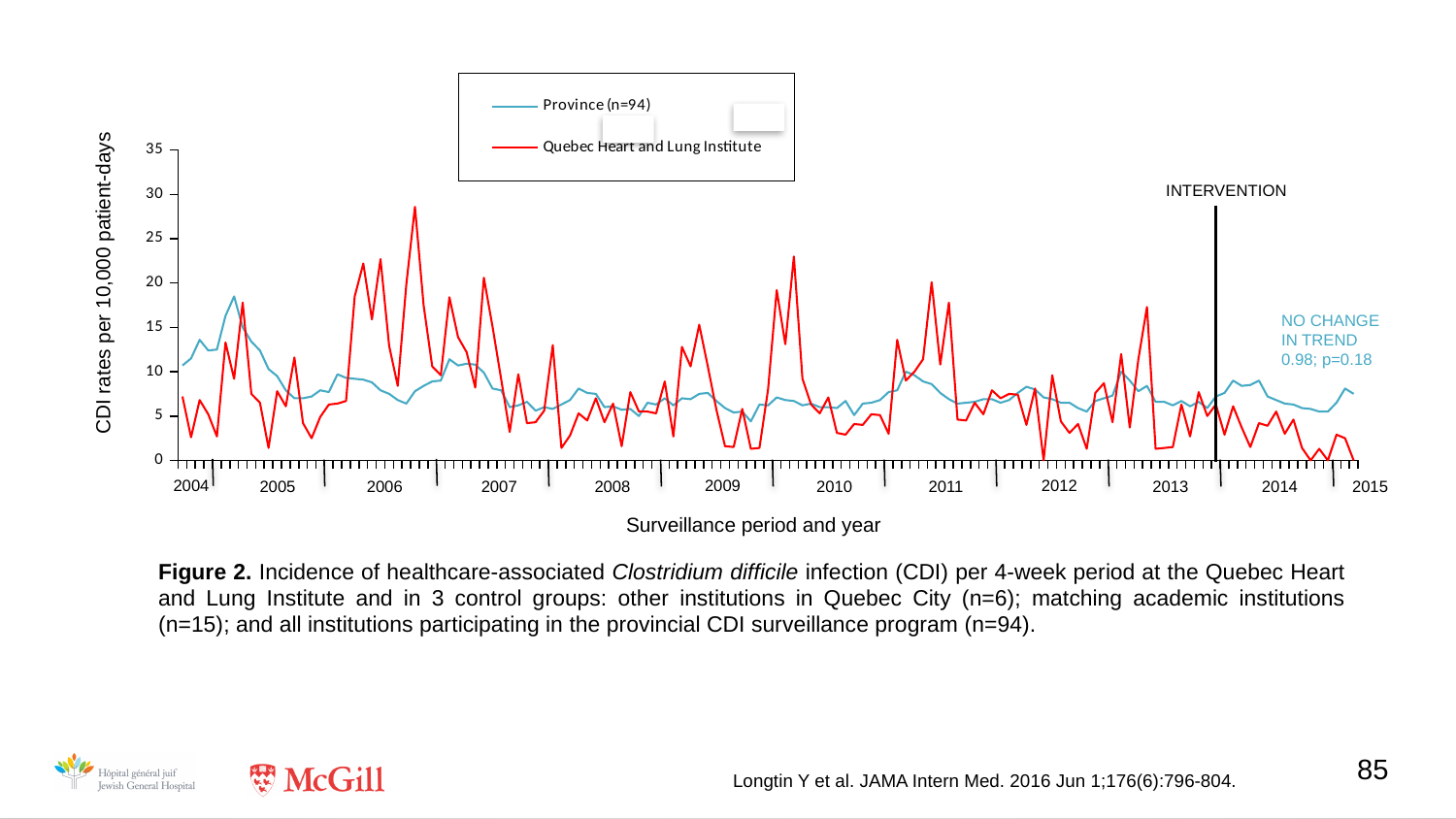
In which year does the Quebec Heart and Lung Institute line reach its highest value? 2006 Is the highest peak of the Province (n=94) line (in 2004) greater or less than 15? greater Is the highest peak of the Quebec Heart and Lung Institute line (in 2006) greater or less than 25? greater How many series does the legend list? 2 What is the label of the y axis? CDI rates per 10,000 patient-days After the INTERVENTION line, does the Quebec Heart and Lung Institute line generally rise or fall? fall Which series reaches the higher peak value over the whole period? Quebec Heart and Lung Institute Is the Province (n=94) value at the end of 2014 greater or less than 10? less What kind of chart is shown on the slide? line chart What is the highest tick value shown on the y axis? 35 Which series is drawn in red? Quebec Heart and Lung Institute